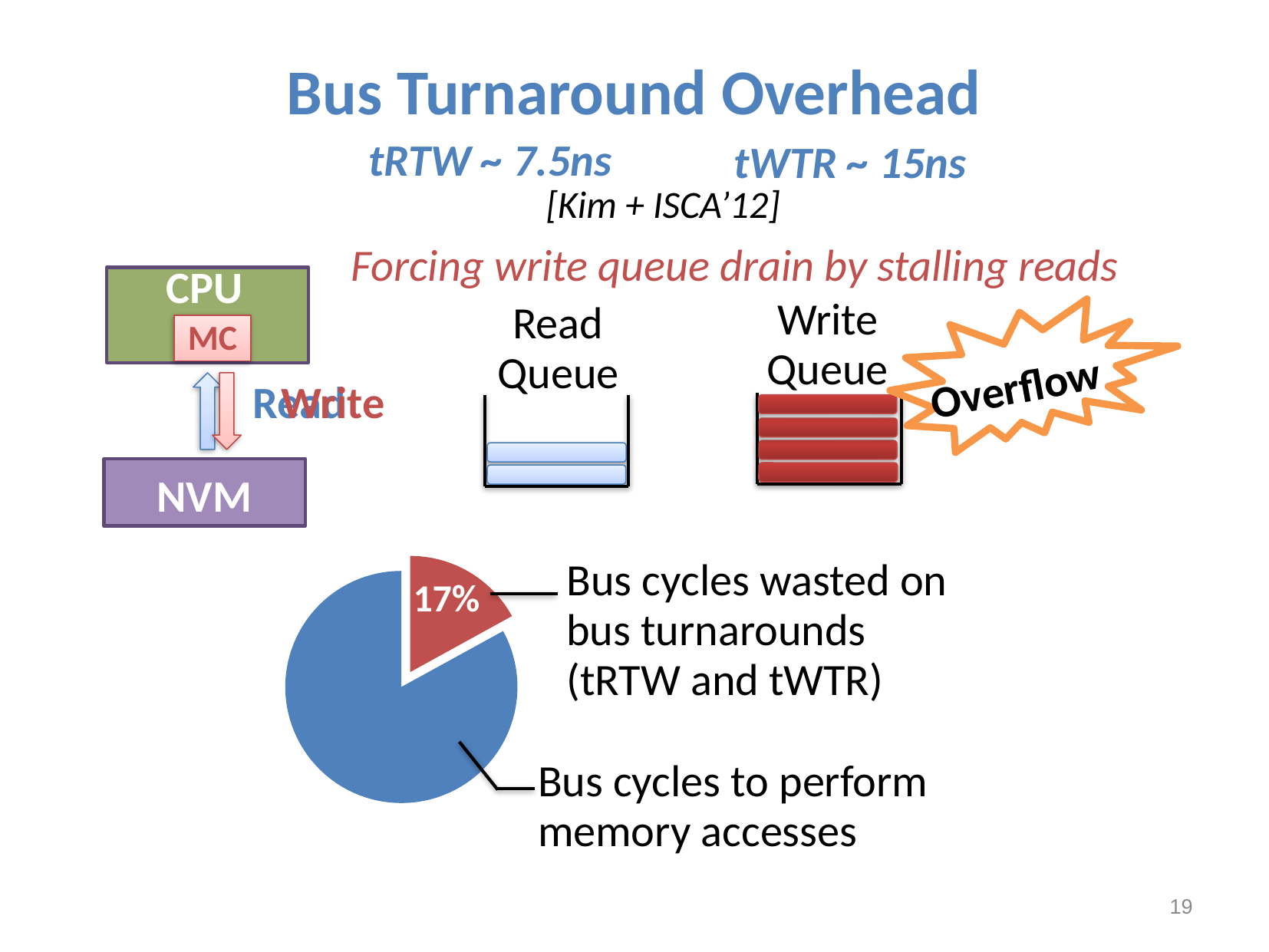
What colour is the slice representing bus cycles wasted on bus turnarounds? Red Which slice of the pie chart is the smallest? Bus cycles wasted on bus turnarounds How many slices does the pie chart have? 2 Which slice of the pie chart is labelled with a percentage value? Bus cycles wasted on bus turnarounds (17%) Which slice of the pie chart is the largest? Bus cycles to perform memory accesses Is the share of bus cycles wasted on bus turnarounds greater or less than 50%? less In the pie chart, which is larger: bus cycles to perform memory accesses or bus cycles wasted on bus turnarounds? Bus cycles to perform memory accesses What colour is the slice representing bus cycles to perform memory accesses? Blue What share of bus cycles is wasted on bus turnarounds (tRTW and tWTR) according to the pie chart? 17% What kind of chart is shown at the bottom of the slide? Pie chart